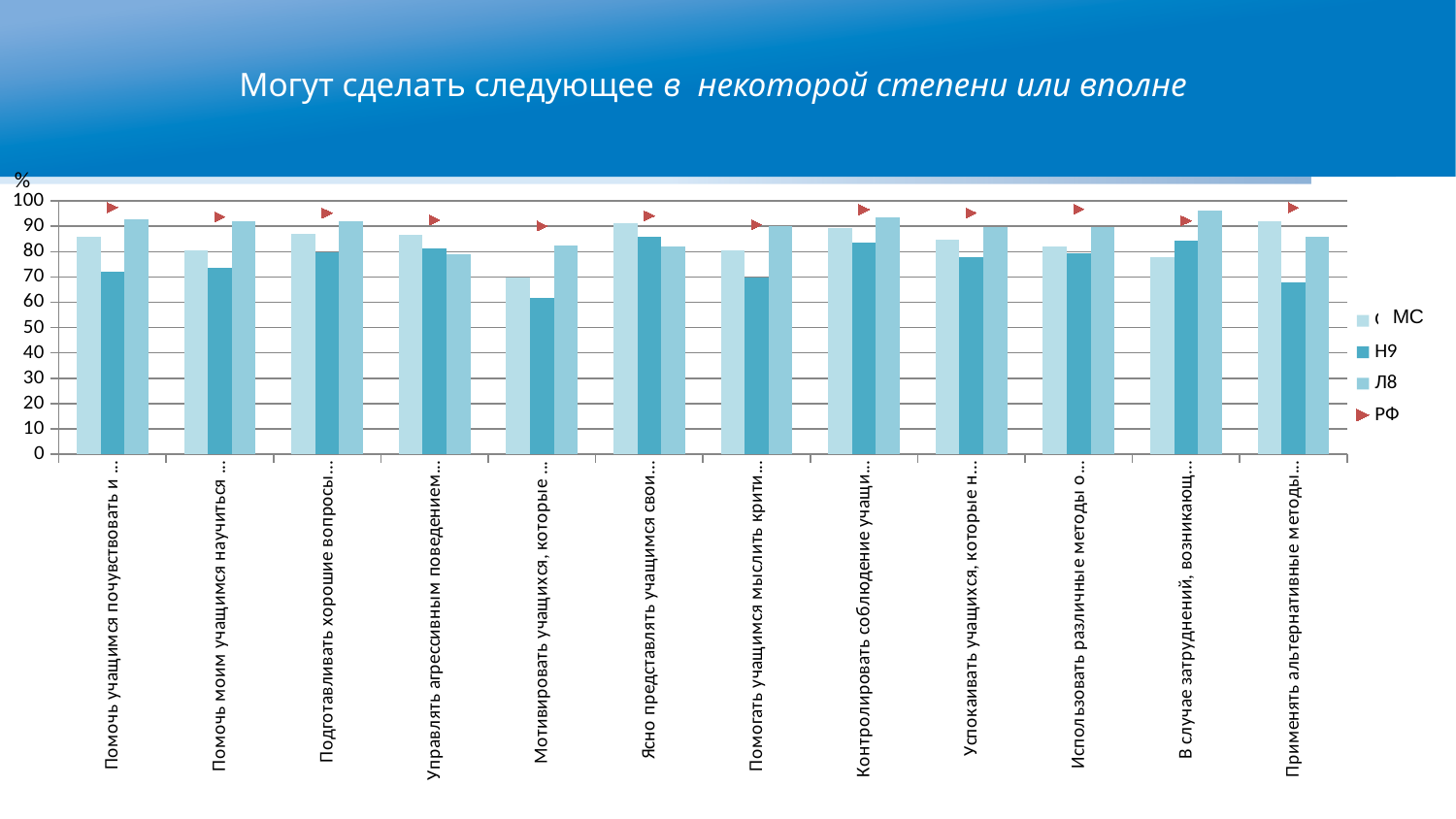
For the category beginning "Мотивировать учащихся, которые", which series has the lowest bar? Н9 For the category beginning "Применять альтернативные методы", which is larger: the МС bar or the Н9 bar? МС Is the Н9 value for the category beginning "Мотивировать учащихся, которые" greater or less than 70? less Which series is shown with triangular markers instead of bars? РФ How many categories are shown along the x axis? 12 How many series does the legend list? 4 For the category beginning "В случае затруднений", which is larger: the МС bar or the Л8 bar? Л8 For which category is the Н9 bar the lowest? Мотивировать учащихся, которые ... What kind of chart is shown on the slide? bar chart Is the Л8 value for the category beginning "Контролировать соблюдение" greater or less than 90? greater Is the Н9 value for the category beginning "Помочь учащимся почувствовать" greater or less than 80? less